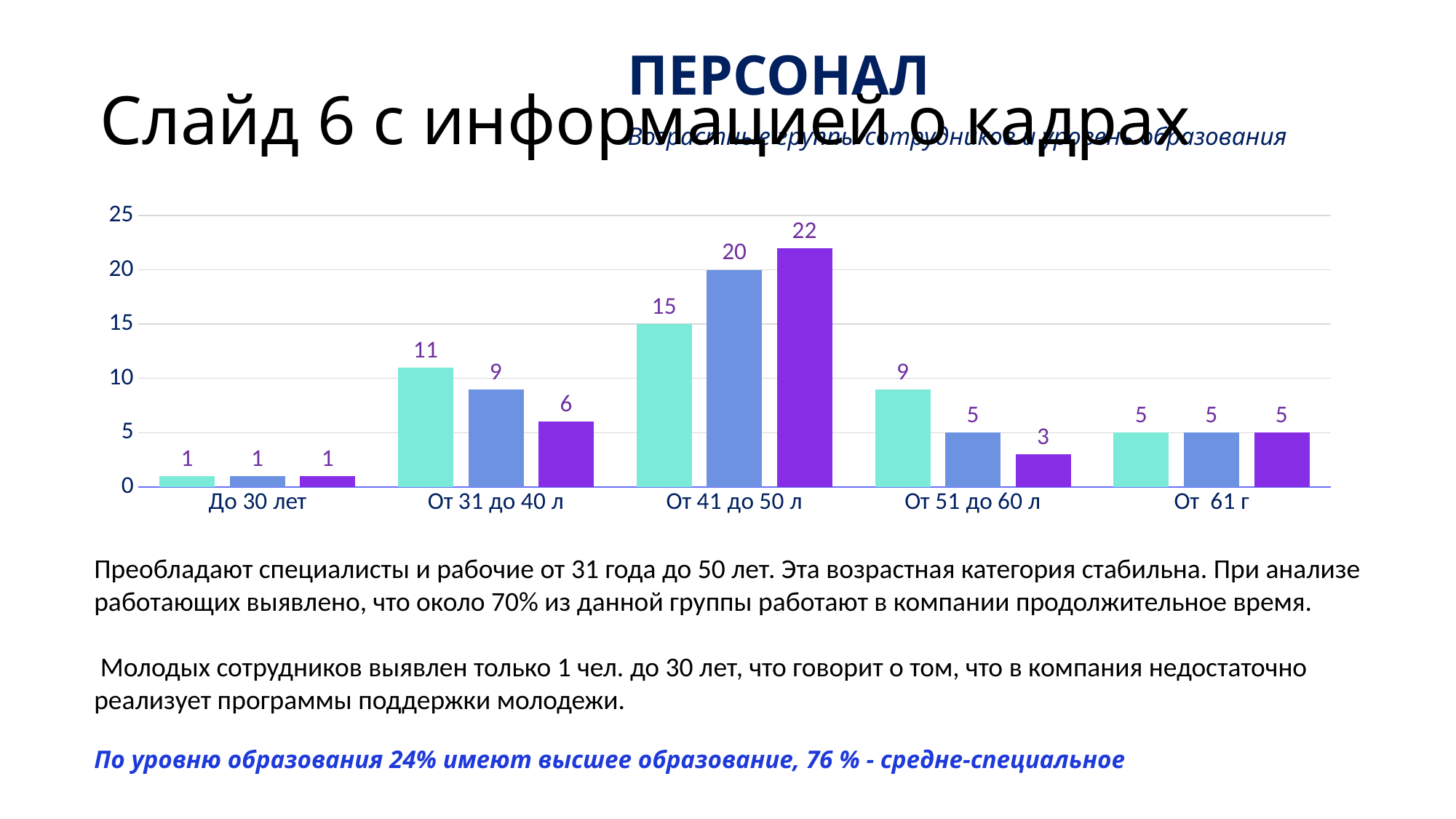
What is the value of the blue bar for the category 'От 51 до 60 л'? 5 Which category has the lowest teal bar? До 30 лет What kind of chart is shown on the slide? bar chart Which category has the highest purple bar? От 41 до 50 л How many age categories are shown on the x axis? 5 What is the value of the purple bar for the category 'От 41 до 50 л'? 22 What is the value of the teal bar for the category 'От 31 до 40 л'? 11 For the category 'От 31 до 40 л', which is larger: the teal bar or the purple bar? the teal bar What is the value of the purple bar for the category 'От 51 до 60 л'? 3 What is the difference between the purple bar and the teal bar for 'От 41 до 50 л'? 7 What is the highest value shown on the vertical axis? 25 What is the total of the three bars for the category 'От 61 г'? 15